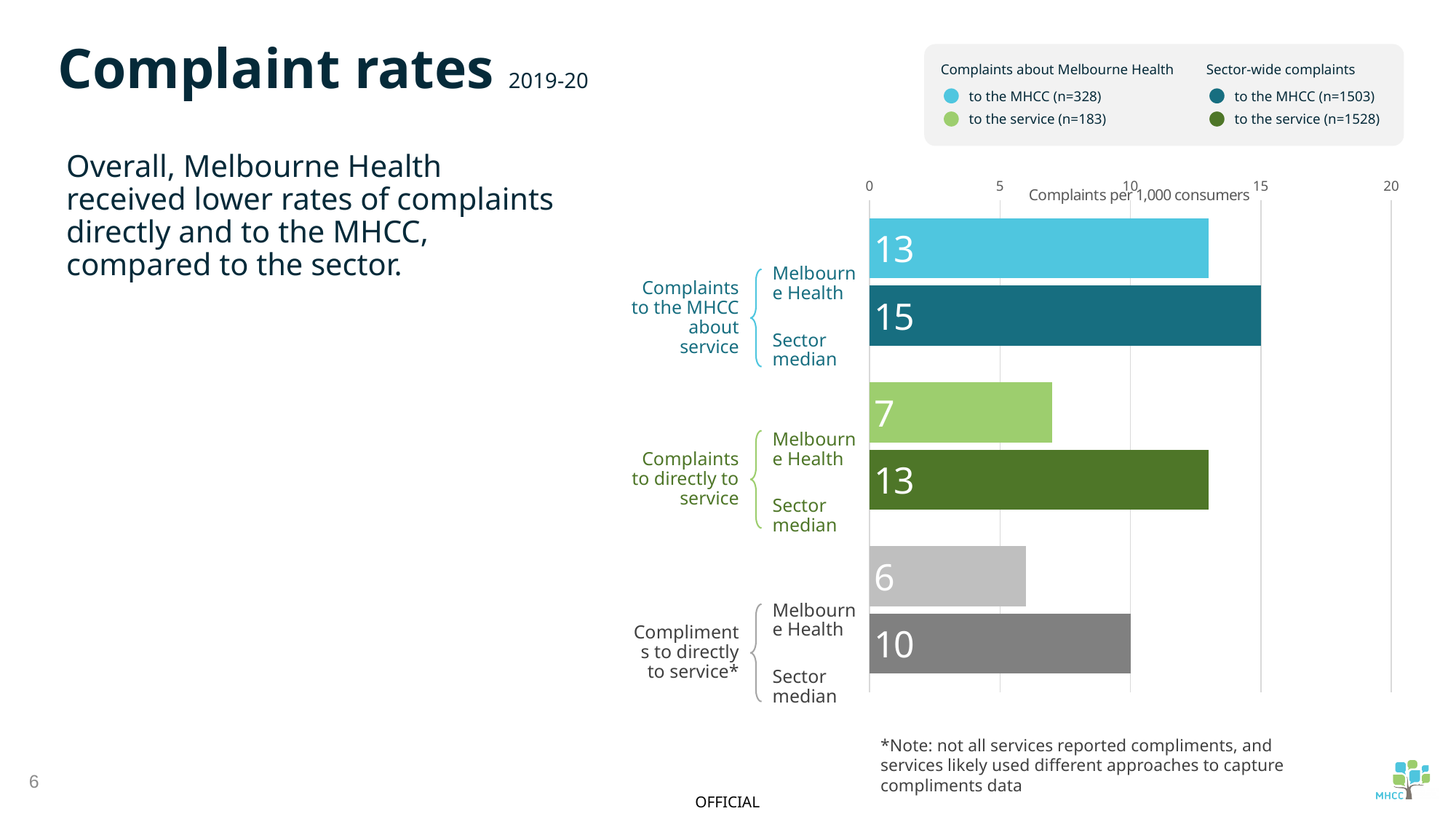
What is the sector median for complaints to the MHCC about service? 15 What is the label of the horizontal axis of the chart? Complaints per 1,000 consumers What is the sector median for compliments directly to service? 10 What is the value for Melbourne Health for complaints directly to service? 7 Which bar has the highest value on the chart? Sector median, complaints to the MHCC about service What is the value for Melbourne Health for complaints to the MHCC about service? 13 How many bars are plotted on the chart? 6 Which is larger for compliments directly to service: Melbourne Health or the sector median? Sector median Which bar has the lowest value on the chart? Melbourne Health, compliments directly to service What kind of chart is shown on the slide? Bar chart What is the difference between the sector median and Melbourne Health for complaints directly to service? 6 Is the sector median for complaints to the MHCC about service greater or less than 10? greater